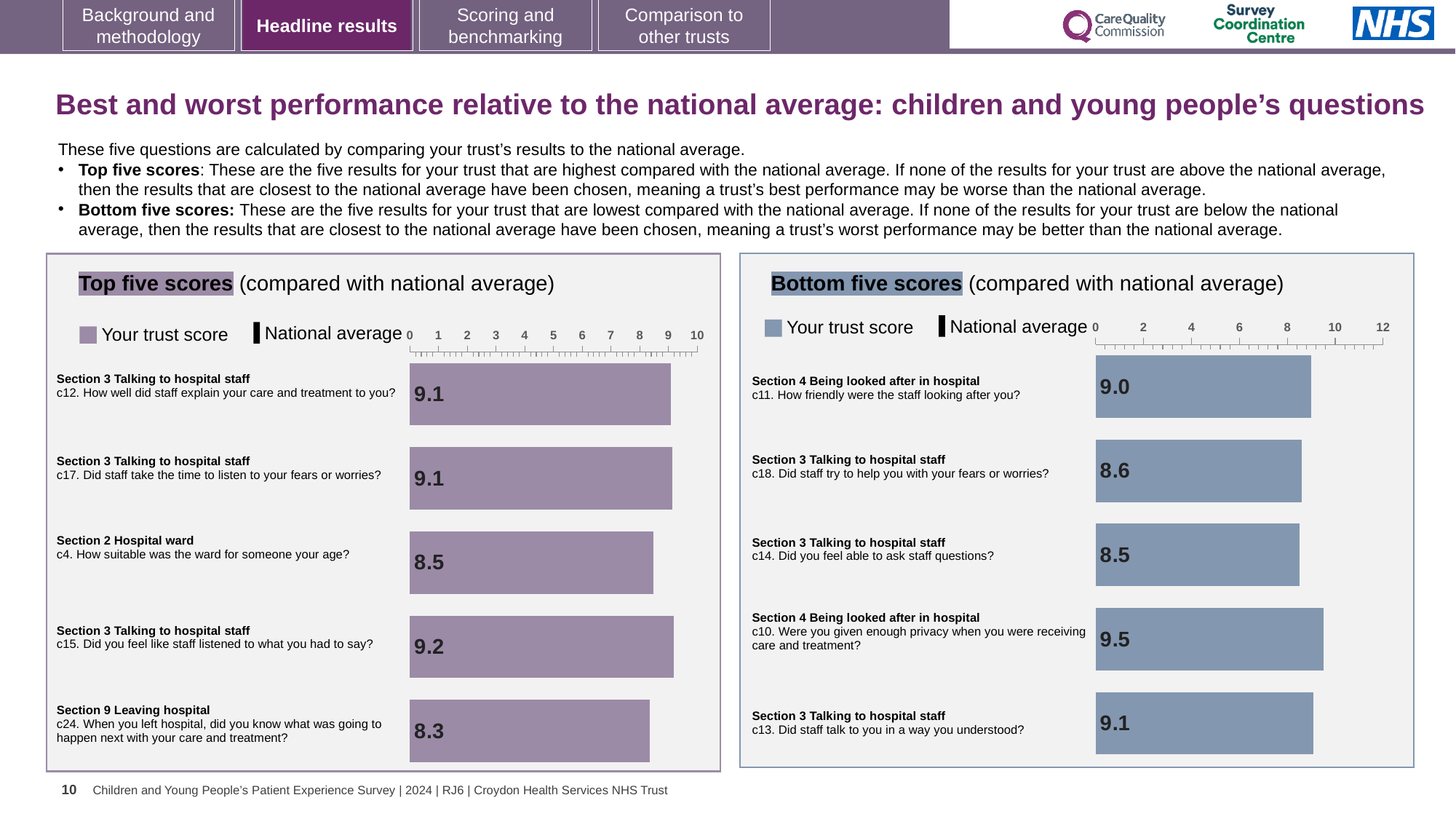
In the Bottom five scores chart, which has the larger trust score: c11 'How friendly were the staff looking after you?' or c13 'Did staff talk to you in a way you understood?' c13. Did staff talk to you in a way you understood? In the Top five scores chart, what is the difference between the trust scores for c15 and c24? 0.9 In the Top five scores chart, what is the trust score for c15 'Did you feel like staff listened to what you had to say?' 9.2 In the Top five scores chart, which question has the highest trust score? c15. Did you feel like staff listened to what you had to say? In the Bottom five scores chart, which question has the lowest trust score? c14. Did you feel able to ask staff questions? In the Top five scores chart, which question has the lowest trust score? c24. When you left hospital, did you know what was going to happen next with your care and treatment? What type of chart is the Top five scores chart? Bar chart In the Bottom five scores chart, what is the trust score for c10 'Were you given enough privacy when you were receiving care and treatment?' 9.5 In the Bottom five scores chart, what is the difference between the trust scores for c10 (privacy) and c14 (able to ask staff questions)? 1.0 In the Top five scores chart, what is the trust score for c24 'When you left hospital, did you know what was going to happen next with your care and treatment?' 8.3 In the Bottom five scores chart, what is the trust score for c18 'Did staff try to help you with your fears or worries?' 8.6 How many questions are plotted in the Bottom five scores chart? 5